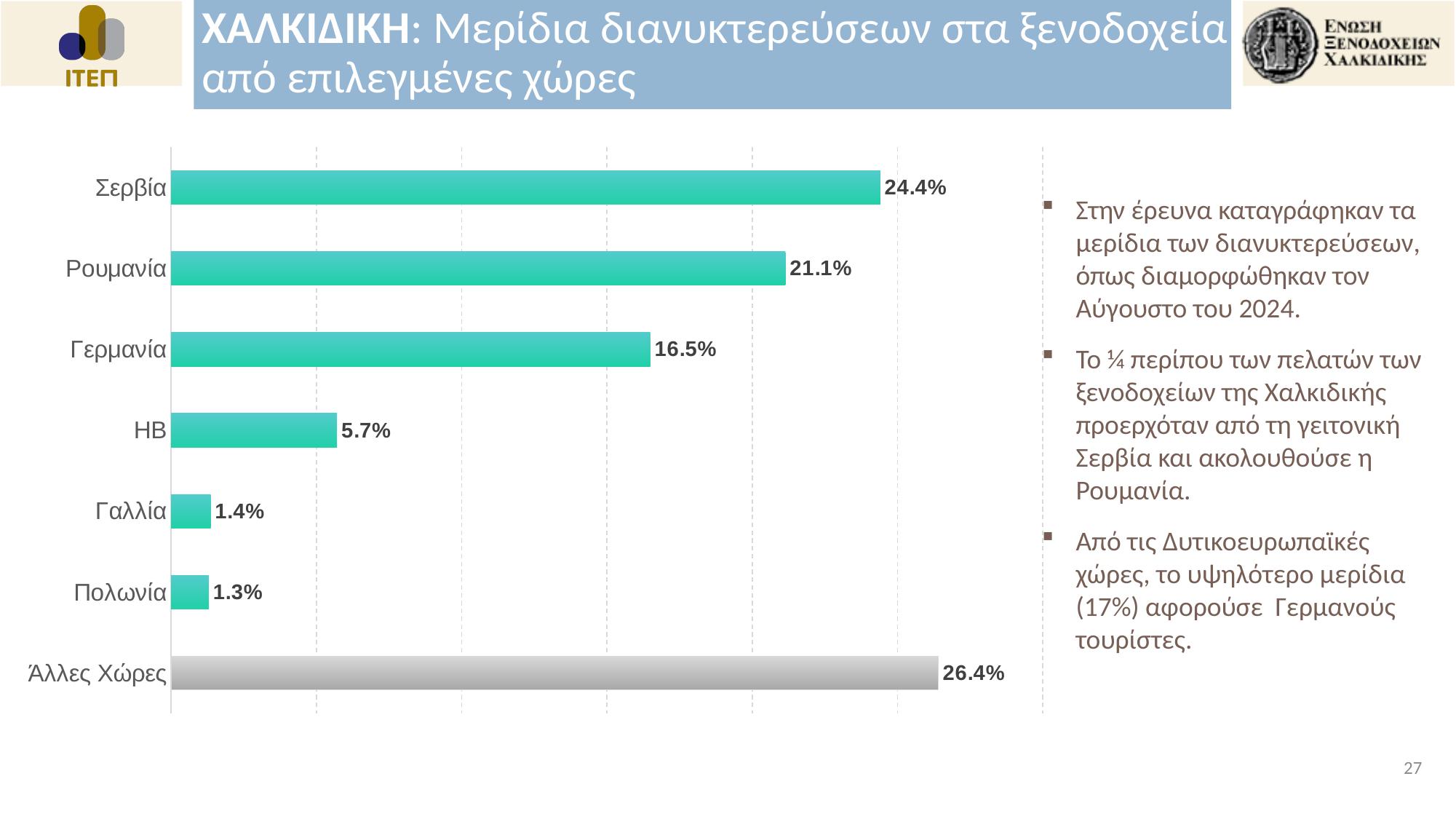
Which category has the lowest value? Πολωνία What is the difference between the values for Σερβία and Ρουμανία? 3.3% What is the value for Άλλες Χώρες? 26.4% What is the value for ΗΒ? 5.7% What kind of chart is shown on the slide? Bar chart Which bar is shown in a different colour (grey) from the others? Άλλες Χώρες How many categories are shown in the chart? 7 Which category has the highest value? Άλλες Χώρες What is the value for Σερβία? 24.4% What is the value for Γερμανία? 16.5% What is the value for Ρουμανία? 21.1% Which is larger, the value for Γερμανία or the value for ΗΒ? Γερμανία